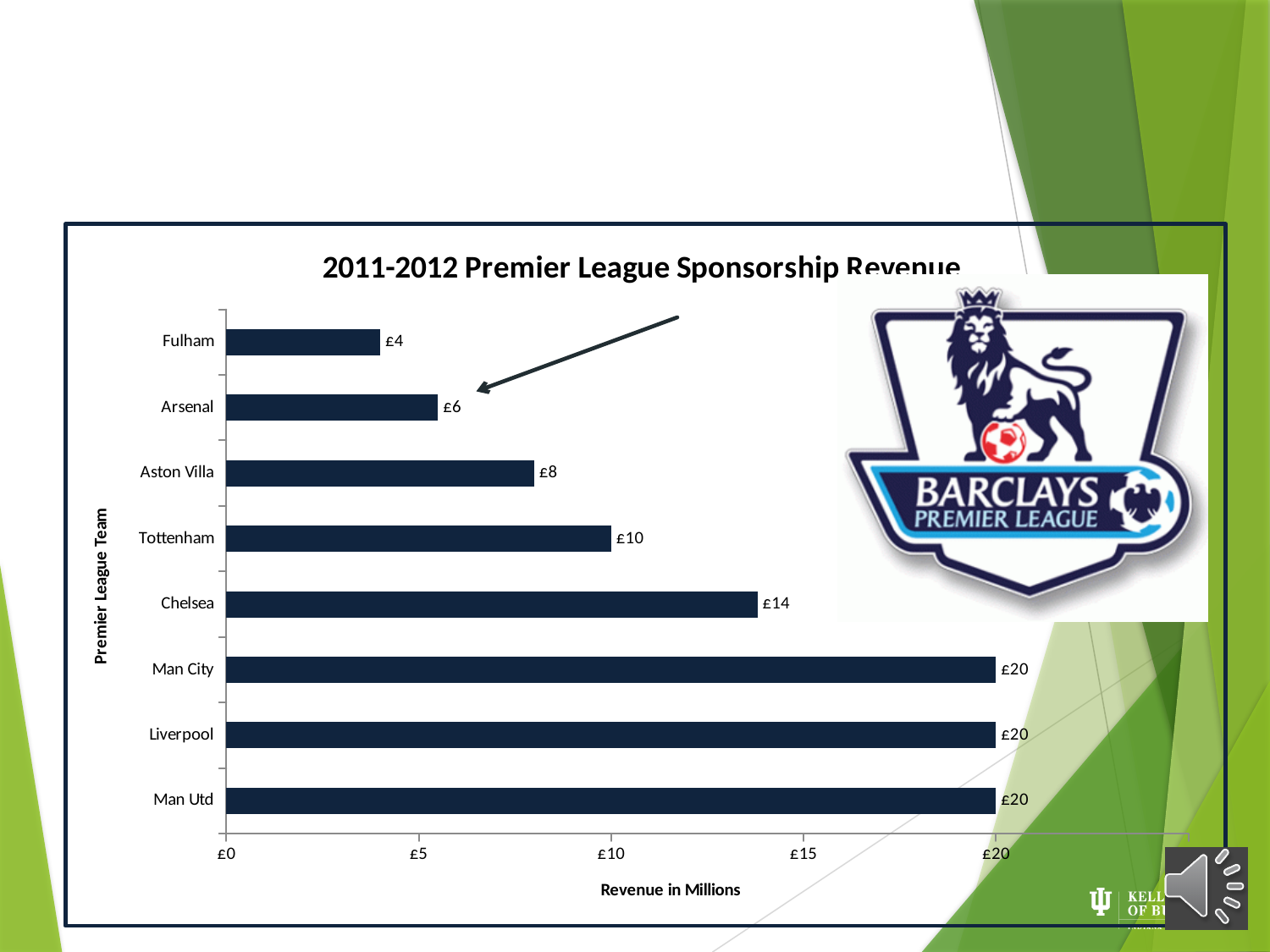
What is the difference in sponsorship revenue between Man City and Tottenham? £10 What is the sponsorship revenue for Arsenal? £6 What is the sponsorship revenue for Chelsea? £14 Which team has the lowest sponsorship revenue? Fulham What is the sponsorship revenue for Man Utd? £20 Is the value for Chelsea greater or less than £10? greater What is the sponsorship revenue for Tottenham? £10 How many teams are shown in the chart? 8 Which has higher sponsorship revenue, Aston Villa or Arsenal? Aston Villa What is the difference in sponsorship revenue between Chelsea and Aston Villa? £6 What is the label of the horizontal axis? Revenue in Millions What kind of chart is shown on the slide? Bar chart